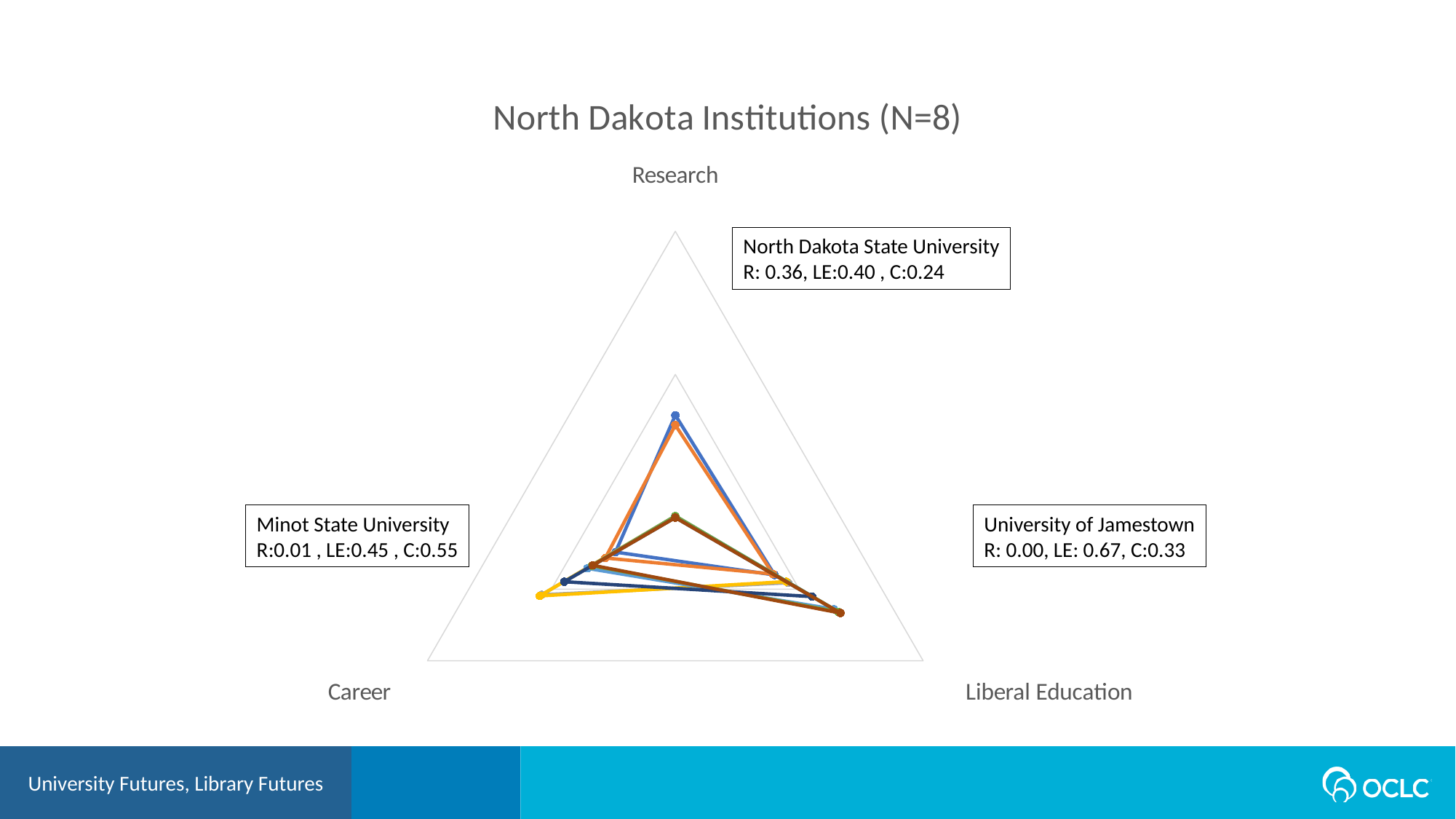
What is the title of the chart? North Dakota Institutions (N=8) According to the callout, what is the Research (R) value for University of Jamestown? 0.00 Which of the three labelled institutions has the highest Research (R) value? North Dakota State University How many axes (categories) does the radar chart have? 3 What kind of chart is shown on the slide? Radar chart Which of the three labelled institutions has the lowest Career (C) value? North Dakota State University According to the callout, what is the Liberal Education (LE) value for University of Jamestown? 0.67 What is the difference between the Liberal Education (LE) values of University of Jamestown and Minot State University? 0.22 According to the callout, what is the Research (R) value for North Dakota State University? 0.36 Which is larger: the Career (C) value for Minot State University or for University of Jamestown? Minot State University According to the callout, what is the Career (C) value for Minot State University? 0.55 What are the three axis labels on the radar chart? Research, Career, Liberal Education